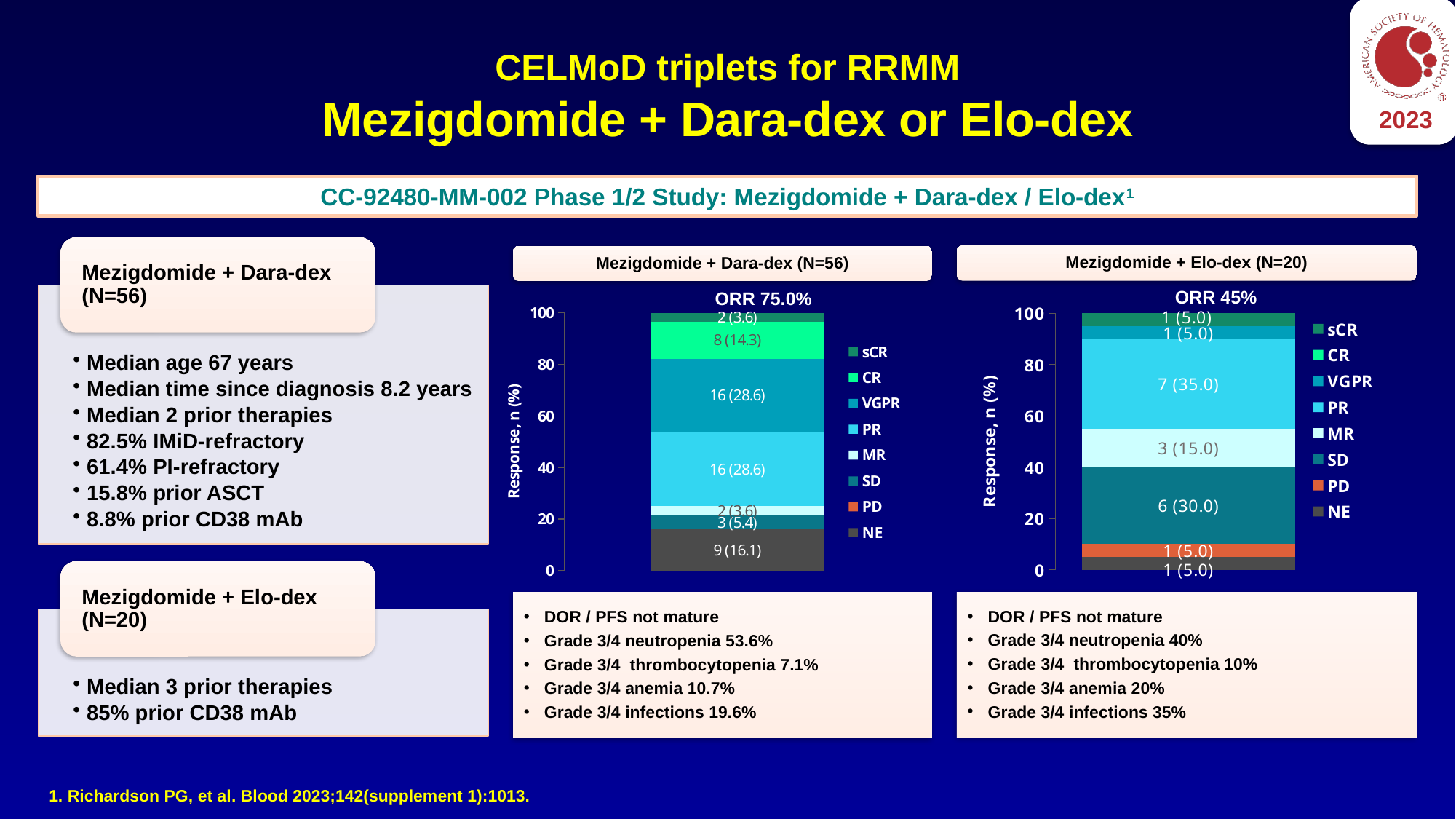
What ORR is shown above the Mezigdomide + Dara-dex (N=56) chart? ORR 75.0% What kind of chart is used to show the response categories for Mezigdomide + Elo-dex (N=20)? Stacked bar chart In the Mezigdomide + Elo-dex (N=20) chart, which response category has the largest segment? PR In the Mezigdomide + Dara-dex (N=56) chart, what is the value labelled for the VGPR segment? 16 (28.6) How many entries does the legend list in the Mezigdomide + Dara-dex (N=56) chart? 8 In the Mezigdomide + Dara-dex (N=56) chart, what is the value labelled for the NE segment? 9 (16.1) In the Mezigdomide + Elo-dex (N=20) chart, what is the value labelled for the SD segment? 6 (30.0) In the Mezigdomide + Dara-dex (N=56) chart, how many more patients had CR than sCR? 6 In the Mezigdomide + Elo-dex (N=20) chart, what is the value labelled for the PR segment? 7 (35.0) In the Mezigdomide + Dara-dex (N=56) chart, what is the value labelled for the CR segment? 8 (14.3) In the Mezigdomide + Elo-dex (N=20) chart, which segment is larger, SD or MR? SD In the Mezigdomide + Elo-dex (N=20) chart, what is the value labelled for the MR segment? 3 (15.0)